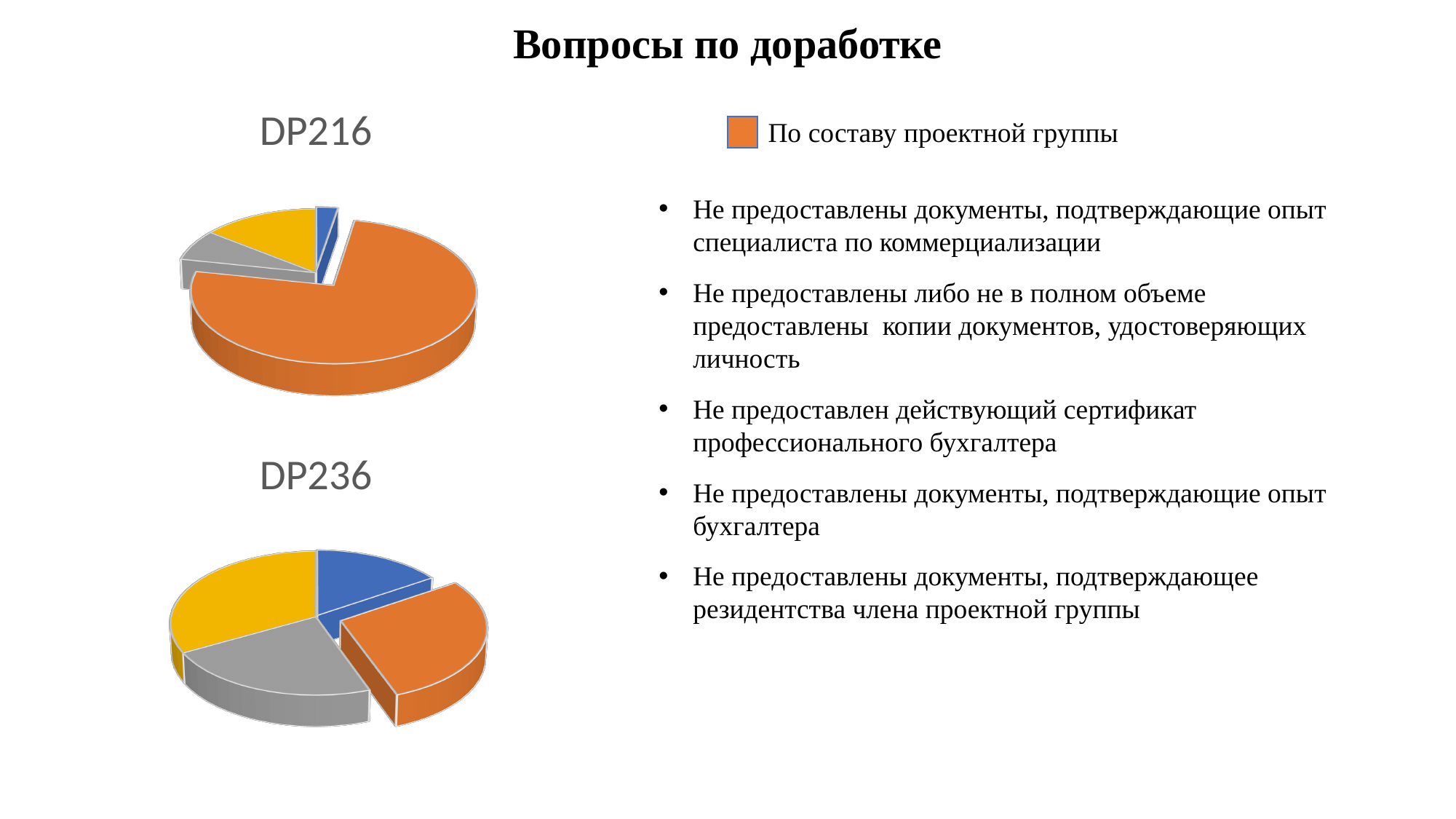
In the DP216 pie chart, which colour slice is the largest? orange In the DP216 pie chart, which colour slice is the smallest? blue What kind of chart is the DP216 chart? pie chart What kind of chart is the DP236 chart? pie chart In the DP236 pie chart, which slice is larger, the orange one or the blue one? orange What are the titles of the two pie charts on the slide? DP216 and DP236 In the DP236 pie chart, which slice is larger, the blue one or the gray one? gray How many slices does the DP216 pie chart have? 4 In the DP216 pie chart, which slice is larger, the orange one or the yellow one? orange What category does the orange legend swatch on the slide represent? По составу проектной группы In the DP236 pie chart, which colour slice is the smallest? blue How many slices does the DP236 pie chart have? 4